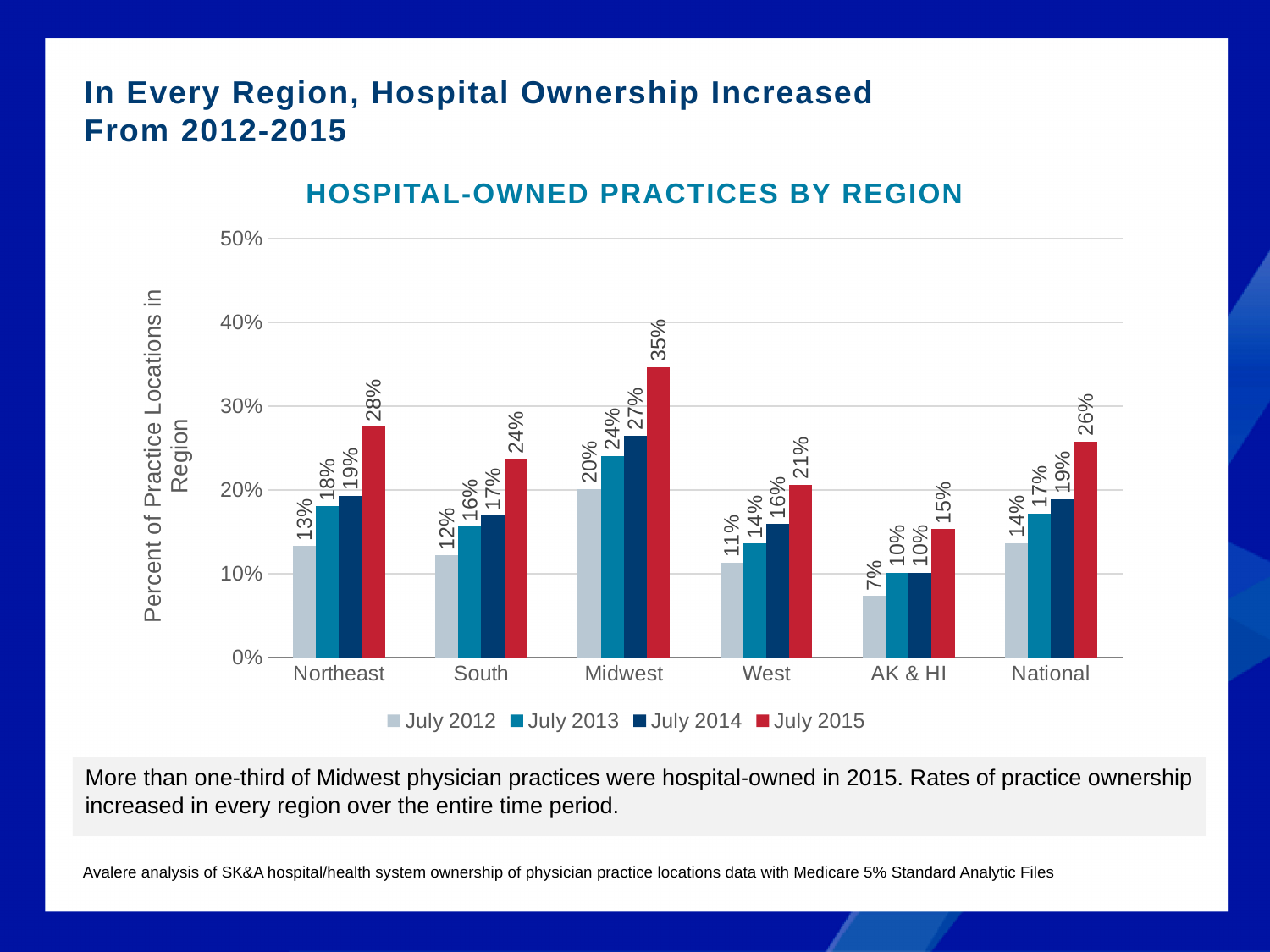
Which region has the highest value in July 2015? Midwest What is the National value for July 2014? 19% What kind of chart is shown? Bar chart Which region has the lowest value in July 2012? AK & HI How many regions (categories) are shown on the x axis? 6 For the Midwest, do the values rise or fall from July 2012 to July 2015? Rise Which is larger: the South's July 2015 value or the West's July 2015 value? South How many series does the legend list? 4 What is the title of the chart? HOSPITAL-OWNED PRACTICES BY REGION What is the value for the Midwest in July 2015? 35% What is the value for AK & HI in July 2012? 7% What is the difference between the Northeast's July 2015 value and its July 2012 value? 15%